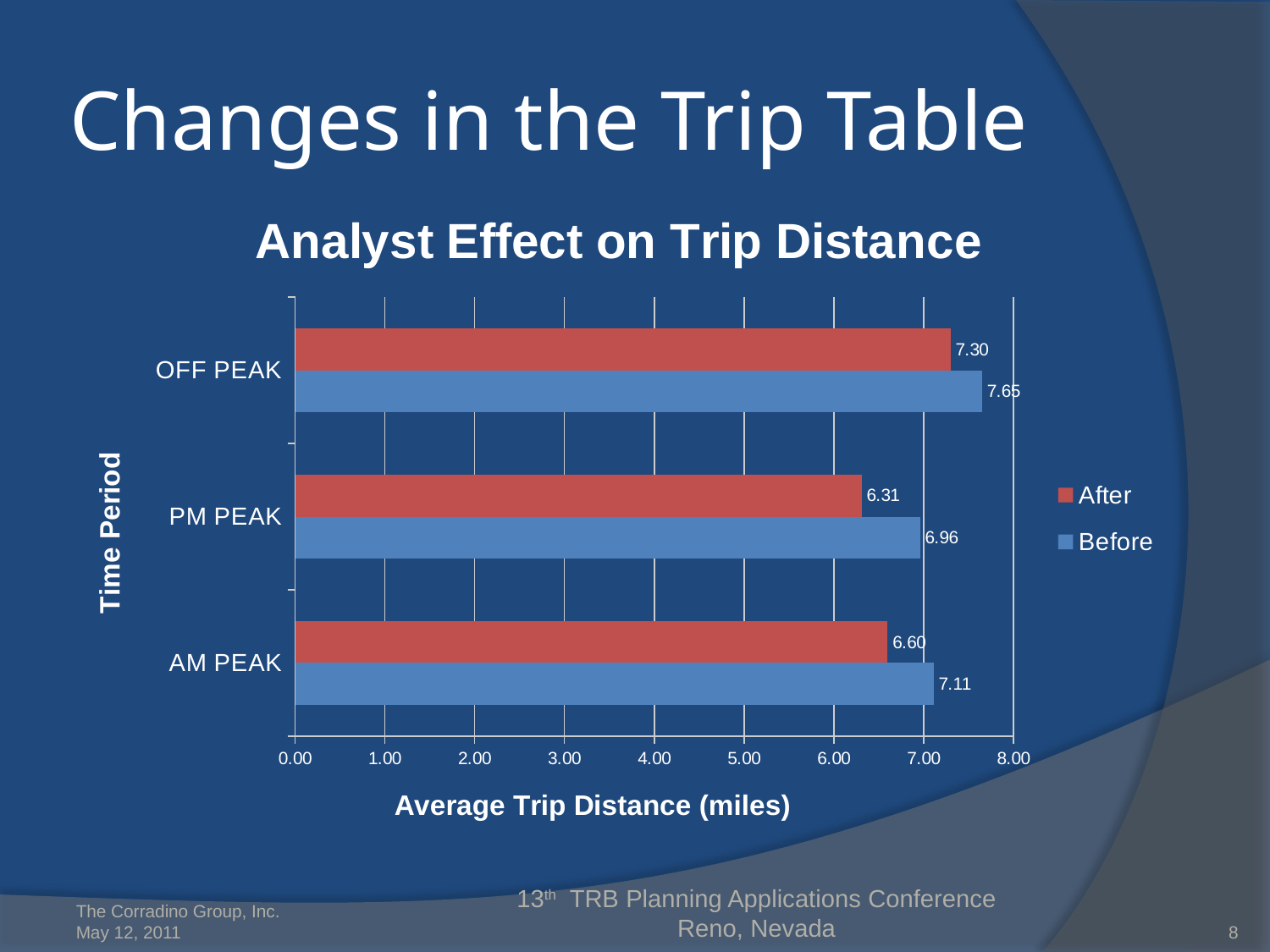
What is the difference between the 'Before' and 'After' values for PM PEAK? 0.65 What is the 'Before' average trip distance for PM PEAK? 6.96 Which is larger for OFF PEAK, the 'Before' value or the 'After' value? Before How many time periods are shown on the chart? 3 What is the 'After' average trip distance for OFF PEAK? 7.30 What is the difference between the 'Before' and 'After' values for AM PEAK? 0.51 Which time period has the highest 'Before' average trip distance? OFF PEAK Which time period has the lowest 'After' average trip distance? PM PEAK What is the 'After' average trip distance for AM PEAK? 6.60 How many series does the legend list? 2 What kind of chart is shown on the slide? Bar chart Is the 'Before' value for AM PEAK greater or less than 7.00? greater